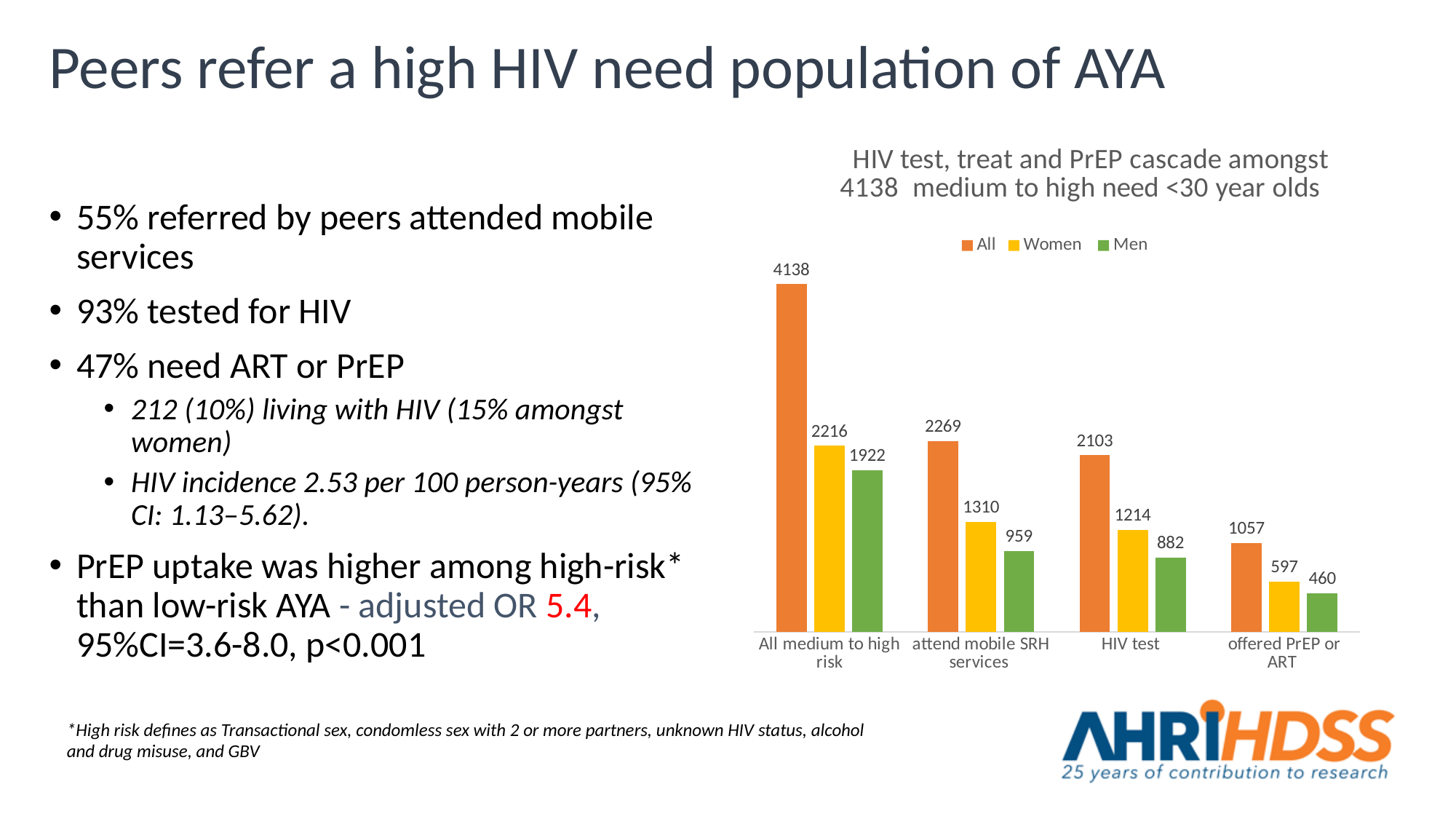
Which is larger: the Women value for 'attend mobile SRH services' or the Women value for 'HIV test'? attend mobile SRH services What kind of chart is shown on the slide? Bar chart How many series does the legend list? 3 What colour represents the Men series in the chart? Green Do the values for the All series rise or fall from left to right across the categories? Fall What is the value for Women in the 'HIV test' category? 1214 Which category has the highest value for the All series? All medium to high risk What is the value for All in the 'attend mobile SRH services' category? 2269 How many categories are shown on the x axis? 4 What is the difference between the Women and Men values in the 'All medium to high risk' category? 294 Which category has the lowest value for the Women series? offered PrEP or ART What is the value for Men in the 'offered PrEP or ART' category? 460